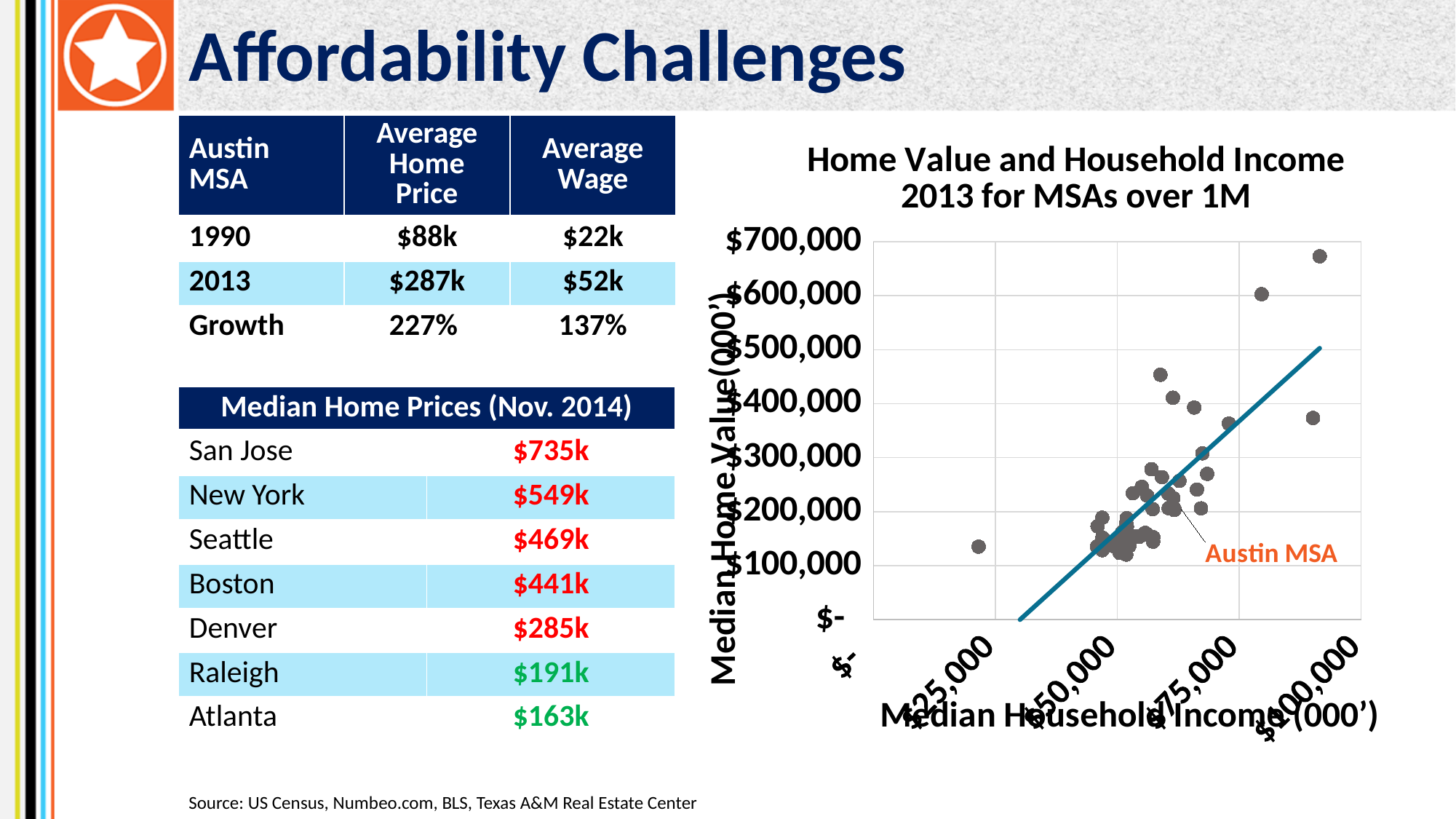
Which MSA is labelled with an annotation on the scatter chart? Austin MSA Does median home value tend to rise or fall as median household income increases along the x axis? rise Is the median household income for the point labelled Austin MSA greater or less than $50,000? greater Is the lowest median home value plotted on the chart greater or less than $200,000? less What kind of chart is shown on the slide? scatter chart Is the median home value for the point labelled Austin MSA greater or less than $300,000? less What is the highest value shown on the y axis of the chart? $700,000 What is the title of the chart? Home Value and Household Income 2013 for MSAs over 1M